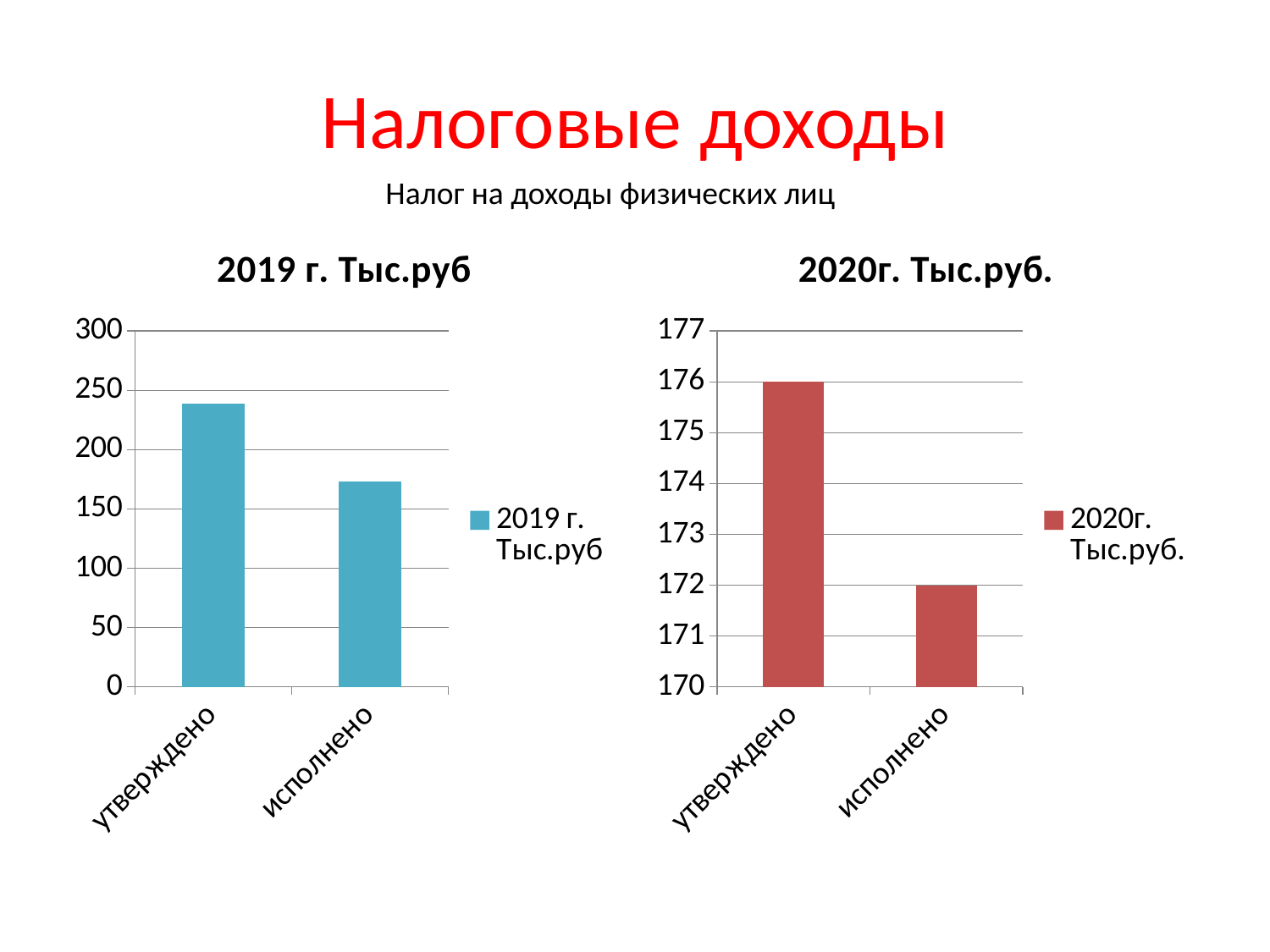
How many series does the legend of the chart titled "2020г. Тыс.руб." list? 1 In the chart titled "2020г. Тыс.руб.", what is the difference between утверждено and исполнено? 4 In the chart titled "2019 г. Тыс.руб", is the value for утверждено greater or less than 250? less How many categories are shown in the chart titled "2020г. Тыс.руб."? 2 In the chart titled "2019 г. Тыс.руб", is the value for исполнено greater or less than 200? less In the chart titled "2019 г. Тыс.руб", is the value for утверждено greater or less than 200? greater In the chart titled "2020г. Тыс.руб.", what is the value for утверждено? 176 What kind of chart is the chart titled "2019 г. Тыс.руб"? bar chart In the chart titled "2020г. Тыс.руб.", what is the value for исполнено? 172 In the chart titled "2020г. Тыс.руб.", which category has the highest value? утверждено In the chart titled "2019 г. Тыс.руб", which category has the lowest value? исполнено In the chart titled "2019 г. Тыс.руб", which is larger, утверждено or исполнено? утверждено